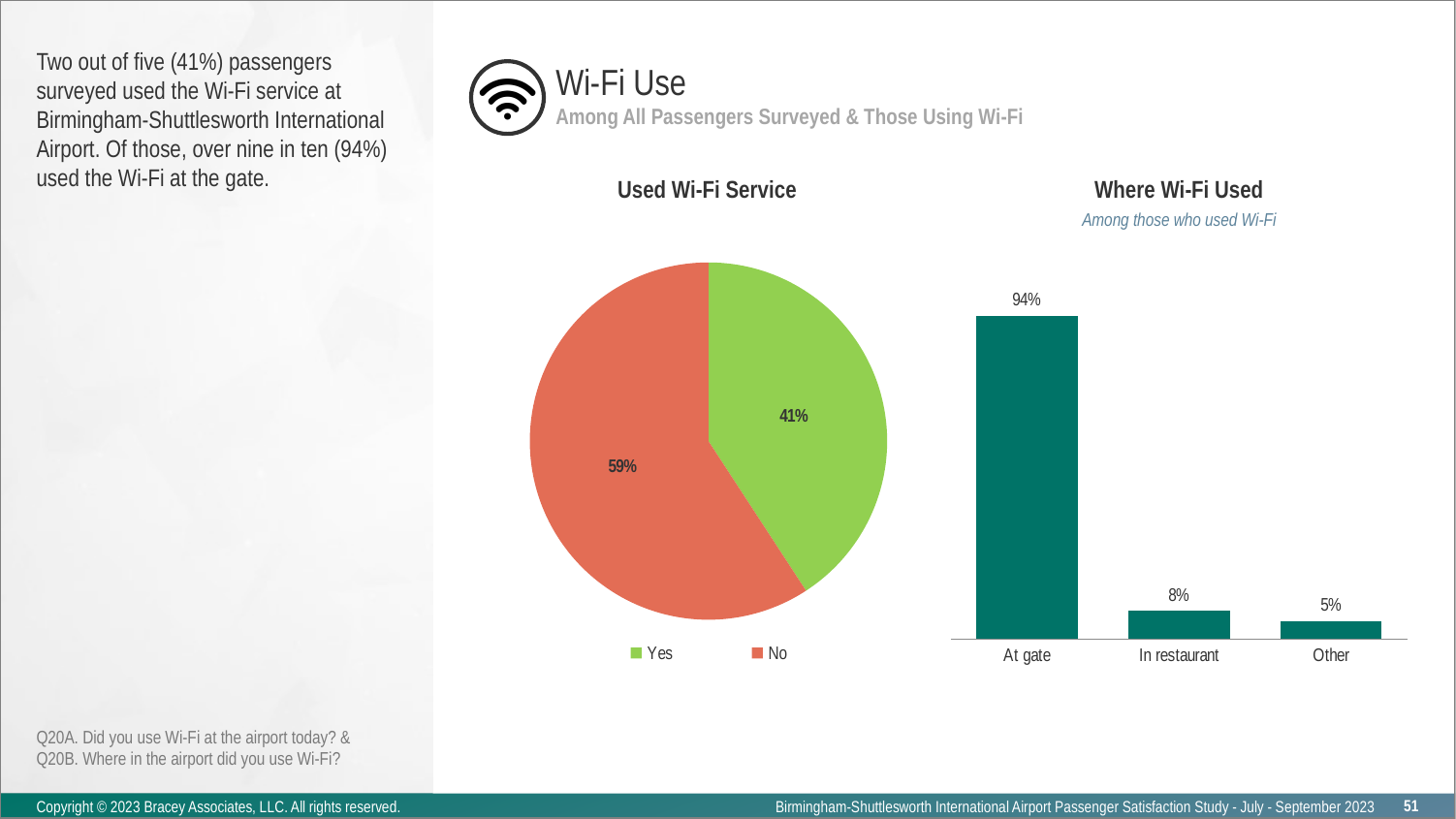
How many entries does the legend of the 'Used Wi-Fi Service' chart list? 2 In the 'Used Wi-Fi Service' chart, what percentage of passengers answered No? 59% How many categories are shown in the 'Where Wi-Fi Used' chart? 3 In the 'Where Wi-Fi Used' chart, what is the value for In restaurant? 8% In the 'Where Wi-Fi Used' chart, what is the value for At gate? 94% In the 'Where Wi-Fi Used' chart, which category has the lowest value? Other What kind of chart is the 'Used Wi-Fi Service' chart? Pie chart In the 'Used Wi-Fi Service' chart, what percentage of passengers answered Yes? 41% In the 'Where Wi-Fi Used' chart, which category has the highest value? At gate In the 'Used Wi-Fi Service' chart, which slice is larger, Yes or No? No In the 'Used Wi-Fi Service' chart, what is the difference between the No and Yes shares? 18% In the 'Where Wi-Fi Used' chart, what is the difference between At gate and In restaurant? 86%